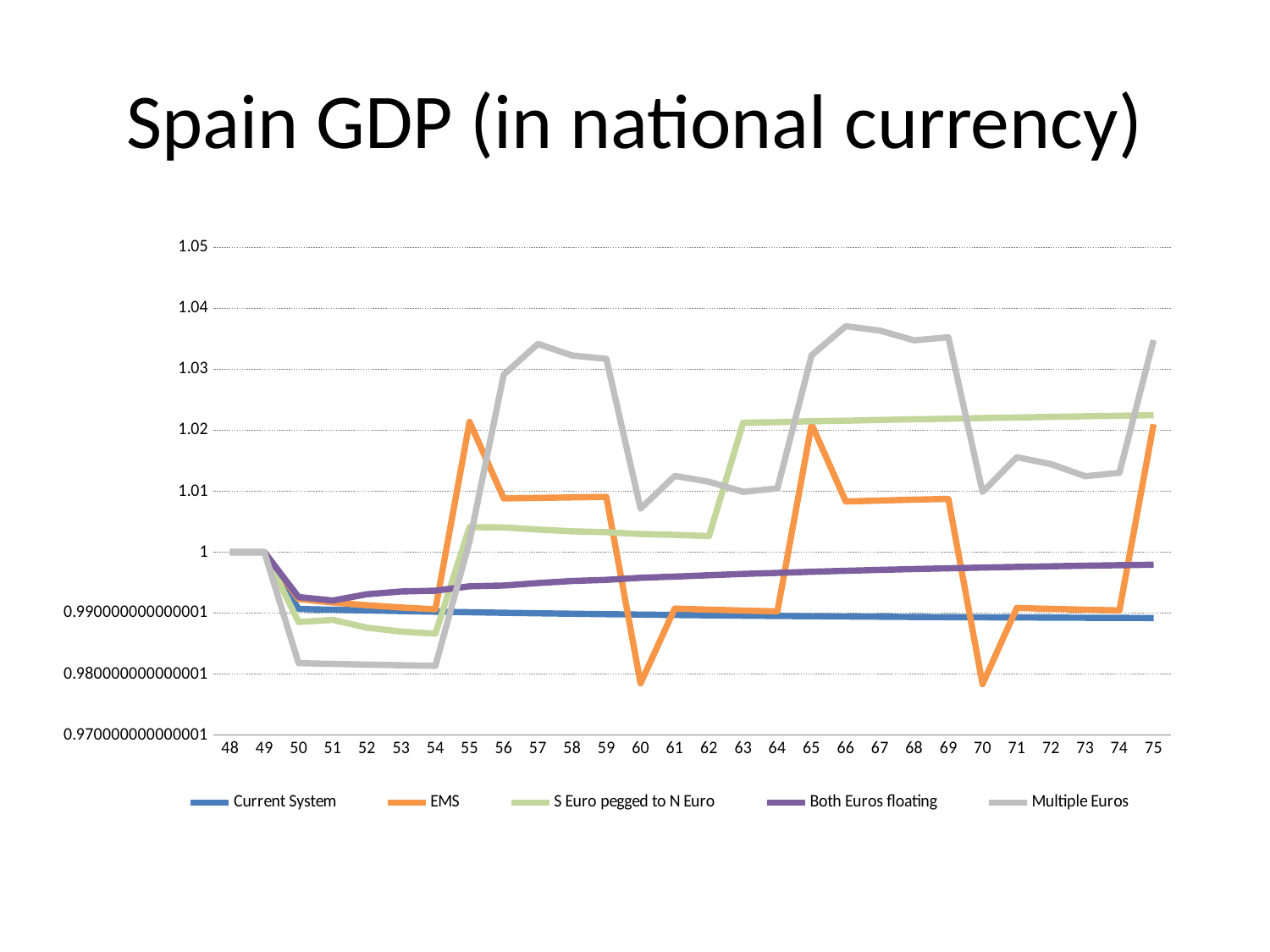
Is the value for Multiple Euros at 66 greater or less than 1.03? greater How many points are on the x axis of the chart? 28 What is the value of the Current System series at 48? 1 What is the title of the chart? Spain GDP (in national currency) At 50, which is larger: the Current System value or the Multiple Euros value? Current System Which series has the highest value at 66? Multiple Euros Does the Both Euros floating series rise or fall from 51 to 75? rise Is the value for EMS at 55 greater or less than 1.01? greater Is the value for Multiple Euros at 50 greater or less than 0.99? less What kind of chart is shown on the slide? line chart How many series does the legend list? 5 Which series has the lowest value at 60? EMS